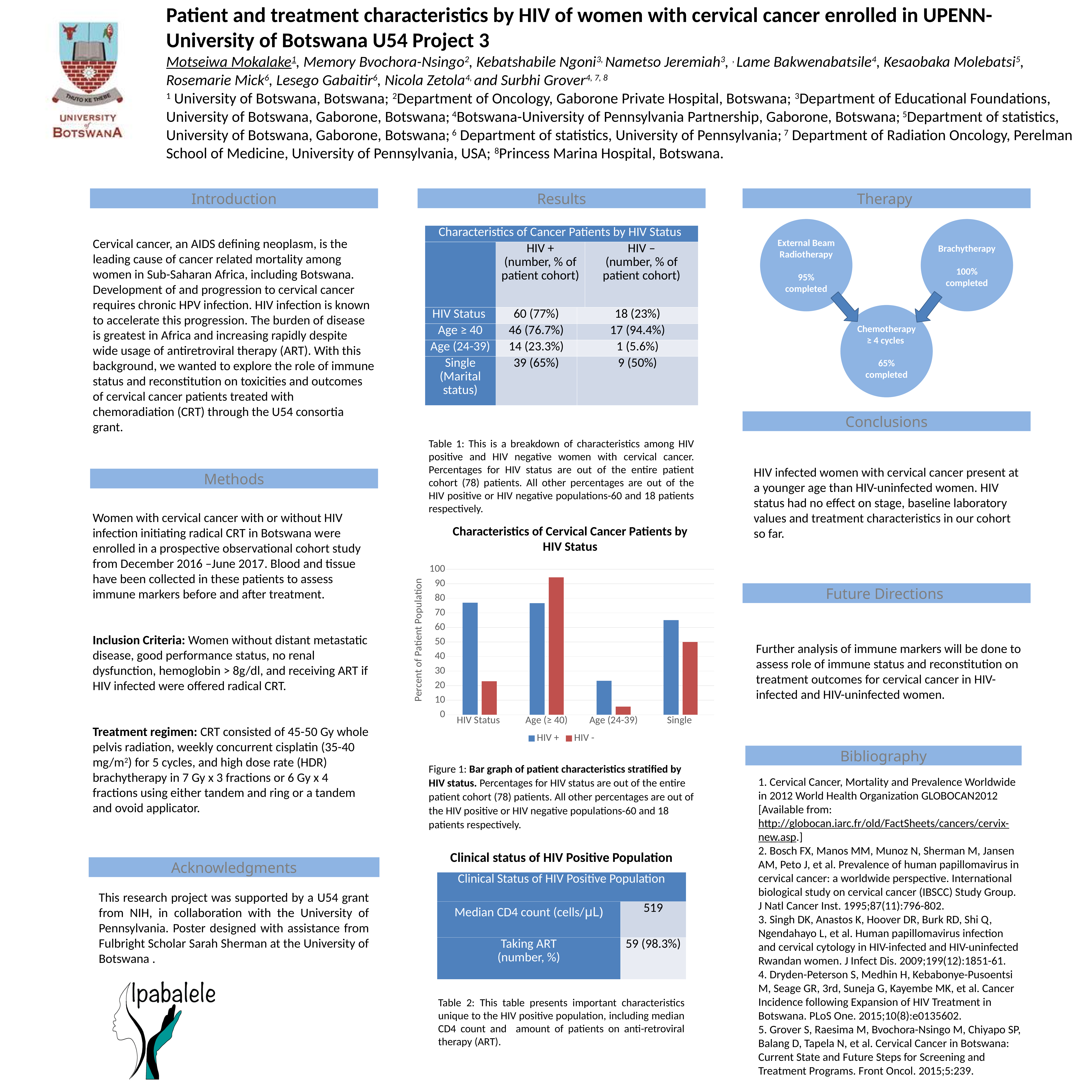
What kind of chart is the "Characteristics of Cervical Cancer Patients by HIV Status" chart? Bar chart In the "Characteristics of Cervical Cancer Patients by HIV Status" chart, which category has the lowest HIV + bar? Age (24-39) How many series does the legend of the "Characteristics of Cervical Cancer Patients by HIV Status" chart list? 2 In the "Characteristics of Cervical Cancer Patients by HIV Status" chart, which category has the highest HIV - bar? Age (≥ 40) In the "Characteristics of Cervical Cancer Patients by HIV Status" chart, is the HIV - value for Age (≥ 40) greater or less than 90? greater In the "Characteristics of Cervical Cancer Patients by HIV Status" chart, is the HIV - value for Age (24-39) greater or less than 10? less What is the y-axis label of the "Characteristics of Cervical Cancer Patients by HIV Status" chart? Percent of Patient Population In the "Characteristics of Cervical Cancer Patients by HIV Status" chart, is the HIV + value for HIV Status greater or less than 70? greater How many categories are shown on the x axis of the "Characteristics of Cervical Cancer Patients by HIV Status" chart? 4 In the "Characteristics of Cervical Cancer Patients by HIV Status" chart, which series has the larger bar for Age (≥ 40), HIV + or HIV -? HIV - In the "Characteristics of Cervical Cancer Patients by HIV Status" chart, which series has the larger bar for Single, HIV + or HIV -? HIV + In the "Characteristics of Cervical Cancer Patients by HIV Status" chart, which category has the lowest HIV - bar? Age (24-39)